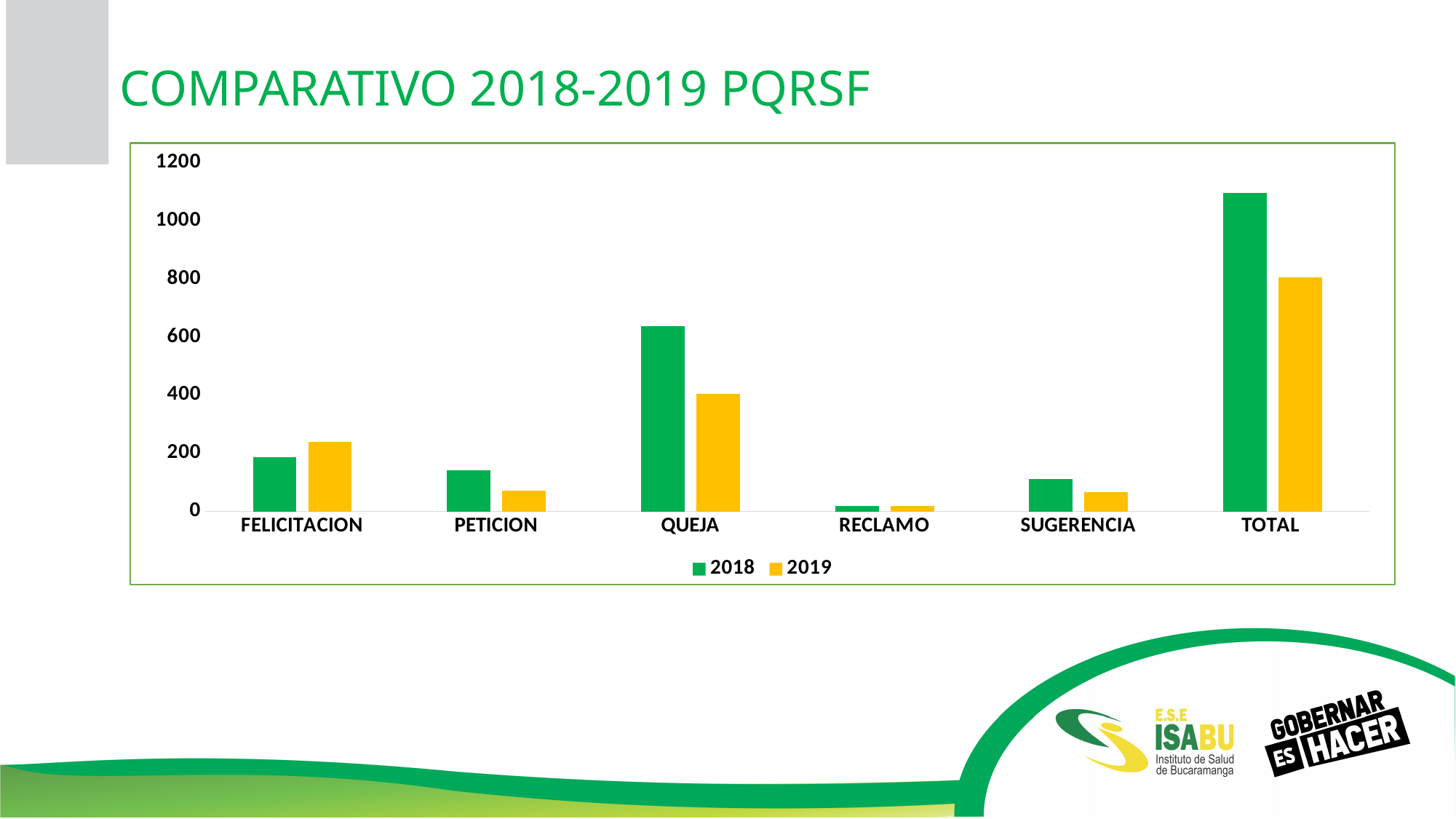
Is the value for PETICION in 2019 greater or less than 100? less For FELICITACION, which year has the larger value, 2018 or 2019? 2019 Is the value for TOTAL in 2018 greater or less than 1000? greater How many categories are shown on the x axis? 6 What kind of chart is shown on the slide? bar chart For QUEJA, which year has the larger value, 2018 or 2019? 2018 Which category has the highest value for 2018? TOTAL Is the value for QUEJA in 2018 greater or less than 600? greater How many series does the legend list? 2 Excluding TOTAL, which category has the highest value for 2019? QUEJA Which category has the lowest value for 2018? RECLAMO What is the title of the slide containing the chart? COMPARATIVO 2018-2019 PQRSF